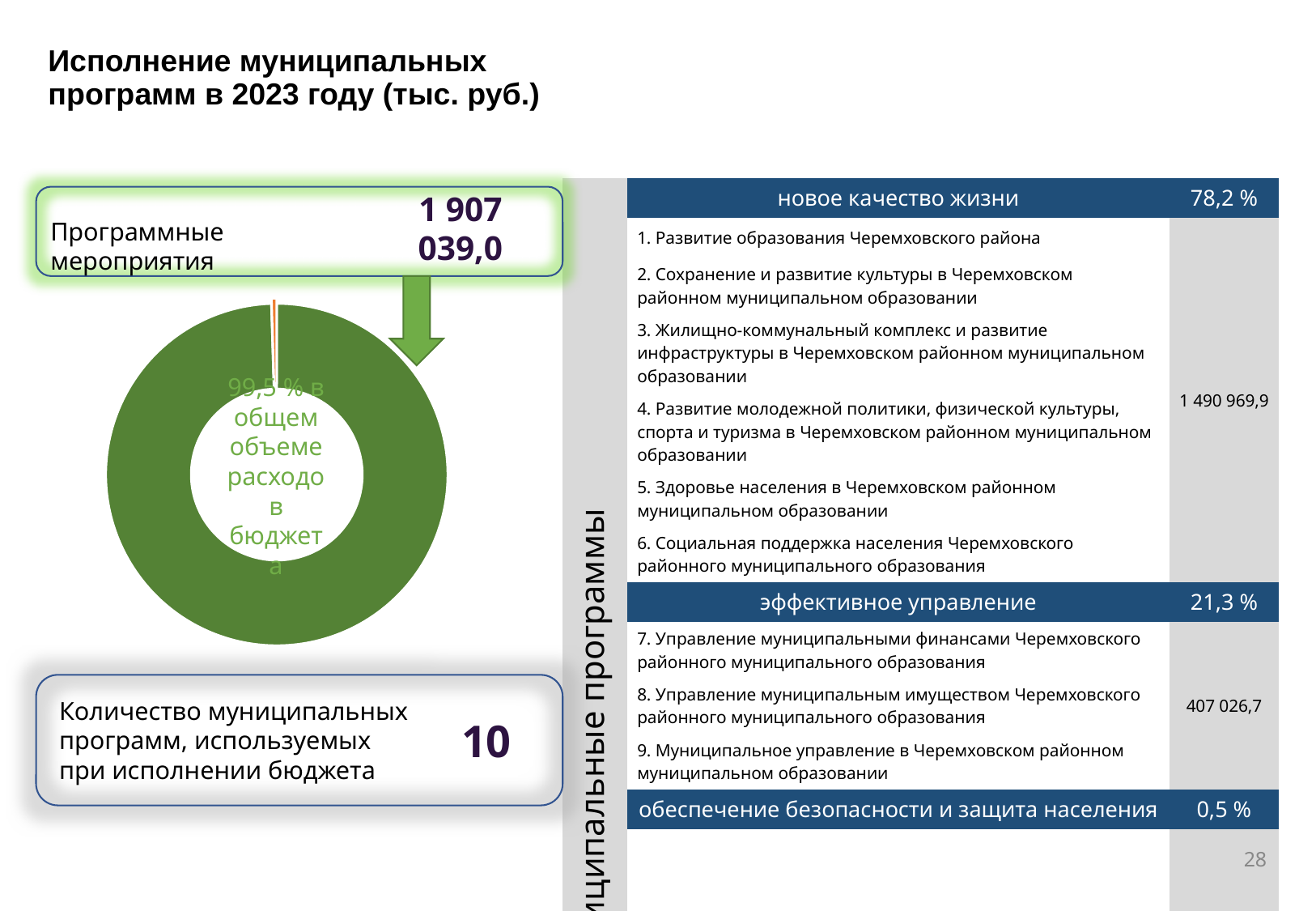
Is the share shown by the green slice of the doughnut chart greater or less than 50%? greater What colour is the dominant slice of the doughnut chart? green Which slice of the doughnut chart is larger, the green one or the orange one? the green one What kind of chart is shown on the left of the slide? doughnut (pie) chart What text is printed inside the doughnut chart? 99,5 % в общем объеме расходов бюджета What share of total budget expenditure does the large green slice of the doughnut chart represent, according to the label printed on it? 99,5 %